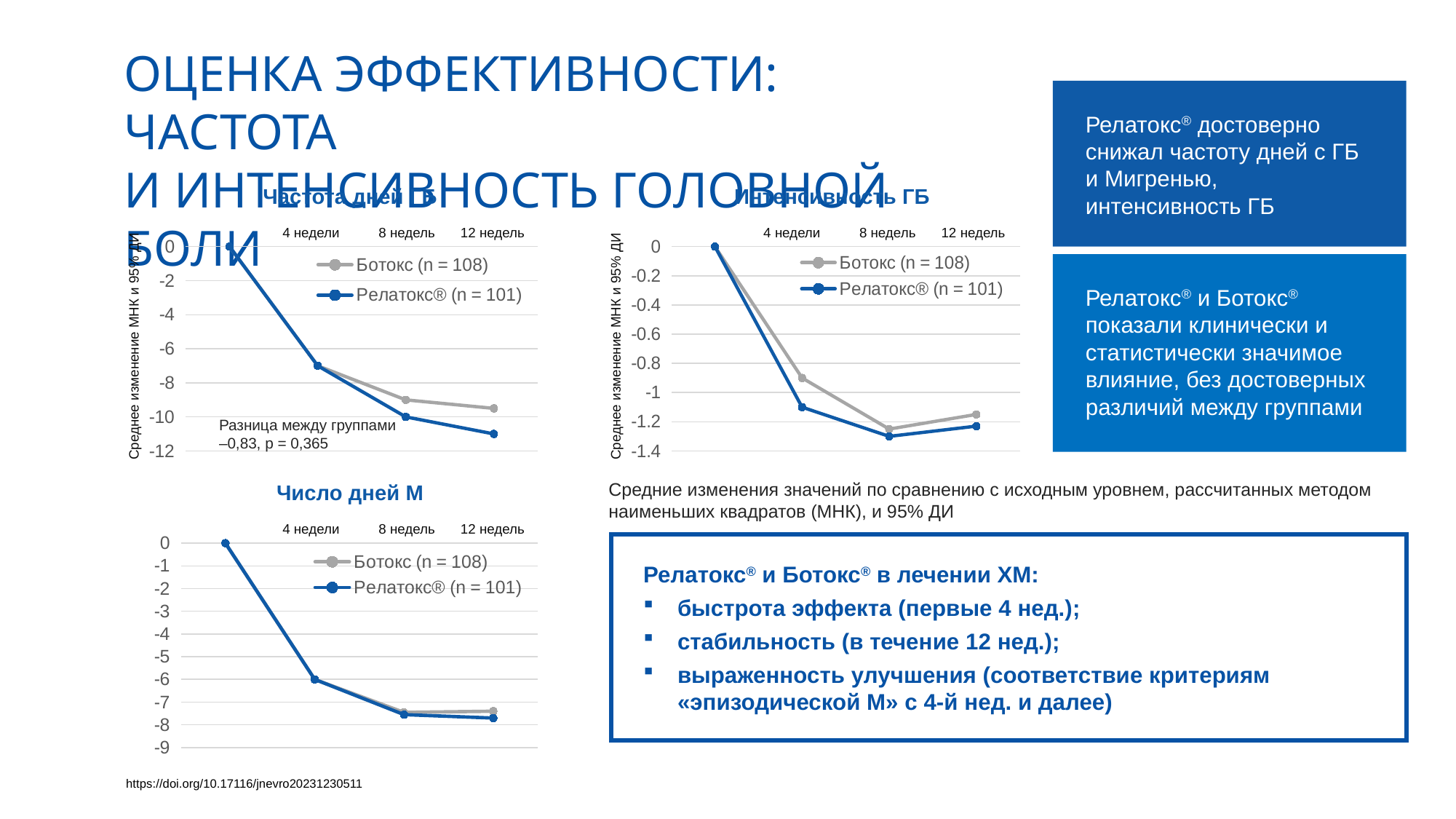
In the top-left chart, is the value for Ботокс at 12 недель greater or less than -10? greater In the top-right chart, is the value for Ботокс at 4 недели greater or less than -1? greater In the top-left chart, is the value for Релатокс® at 12 недель greater or less than -10? less In the top-left chart, do the values rise or fall from the start to 12 недель? fall In the top-right chart, which series has the higher value at 4 недели, Ботокс or Релатокс®? Ботокс In the bottom-left chart "Число дней М", what are the two legend entries? Ботокс (n = 108) and Релатокс® (n = 101) What difference between groups is annotated on the top-left chart? –0,83, p = 0,365 How many series does the legend of the bottom-left chart "Число дней М" list? 2 In the top-left chart, which series has the lower value at 12 недель, Ботокс or Релатокс®? Релатокс® What kind of chart is the bottom-left chart titled "Число дней М"? line chart